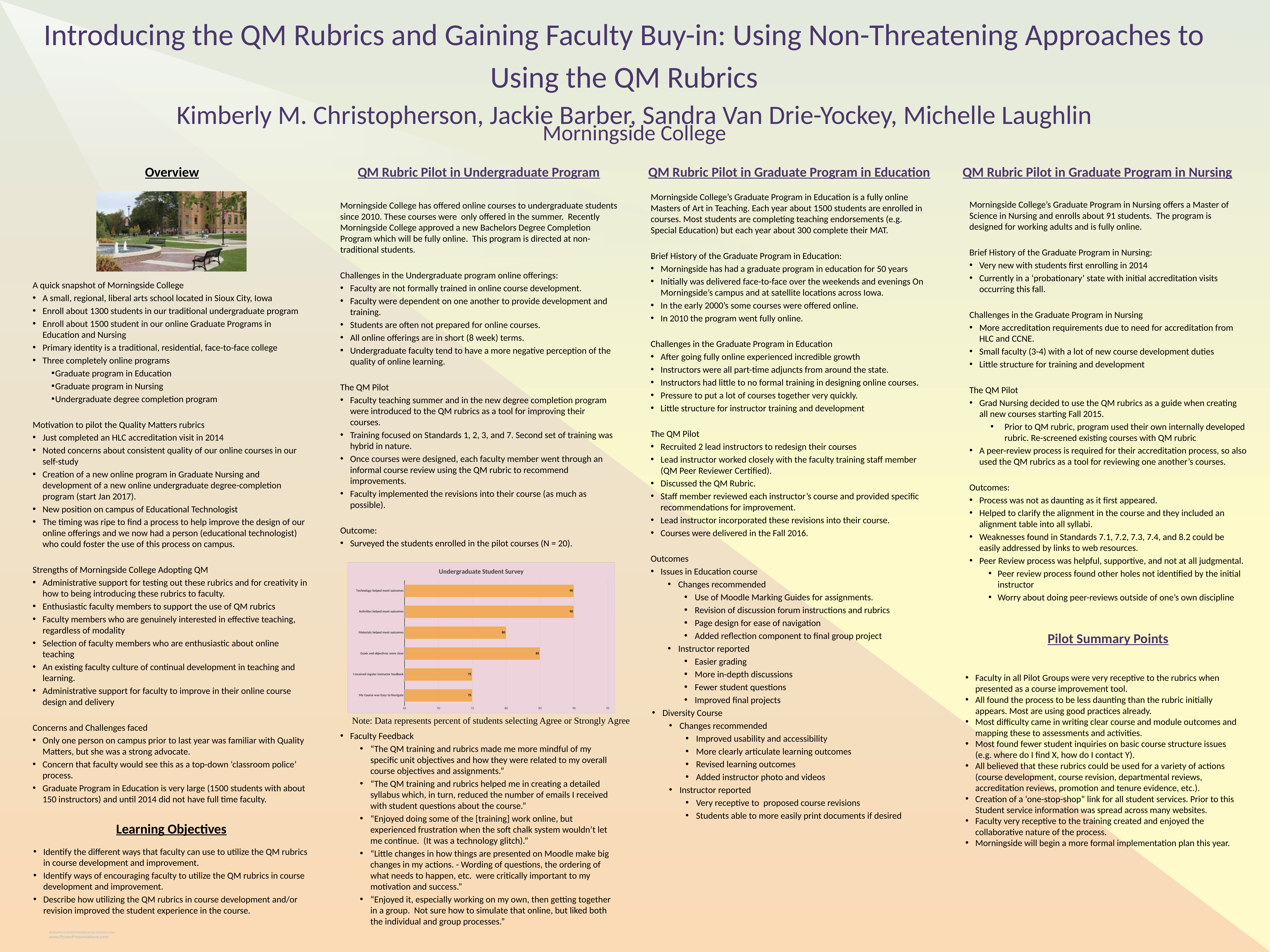
In the Undergraduate Student Survey chart, what is the difference between "Activities helped meet outcomes" and "Materials helped meet outcomes"? 10 In the Undergraduate Student Survey chart, what is the difference between "Goals and objectives were clear" and "I received regular instructor feedback"? 10 What is the title of the chart on the slide? Undergraduate Student Survey In the Undergraduate Student Survey chart, what is the value for "My Course was Easy to Navigate"? 75 In the Undergraduate Student Survey chart, is the value for "I received regular instructor feedback" greater or less than 80? less In the Undergraduate Student Survey chart, which is larger: "Materials helped meet outcomes" or "Goals and objectives were clear"? Goals and objectives were clear In the Undergraduate Student Survey chart, what is the value for "Goals and objectives were clear"? 85 In the Undergraduate Student Survey chart, what is the value for "Materials helped meet outcomes"? 80 How many categories are shown in the Undergraduate Student Survey chart? 6 In the Undergraduate Student Survey chart, what is the value for "Technology helped meet outcomes"? 90 What type of chart is the Undergraduate Student Survey chart? bar chart According to the note below the chart, what does the data in the Undergraduate Student Survey chart represent? Percent of students selecting Agree or Strongly Agree